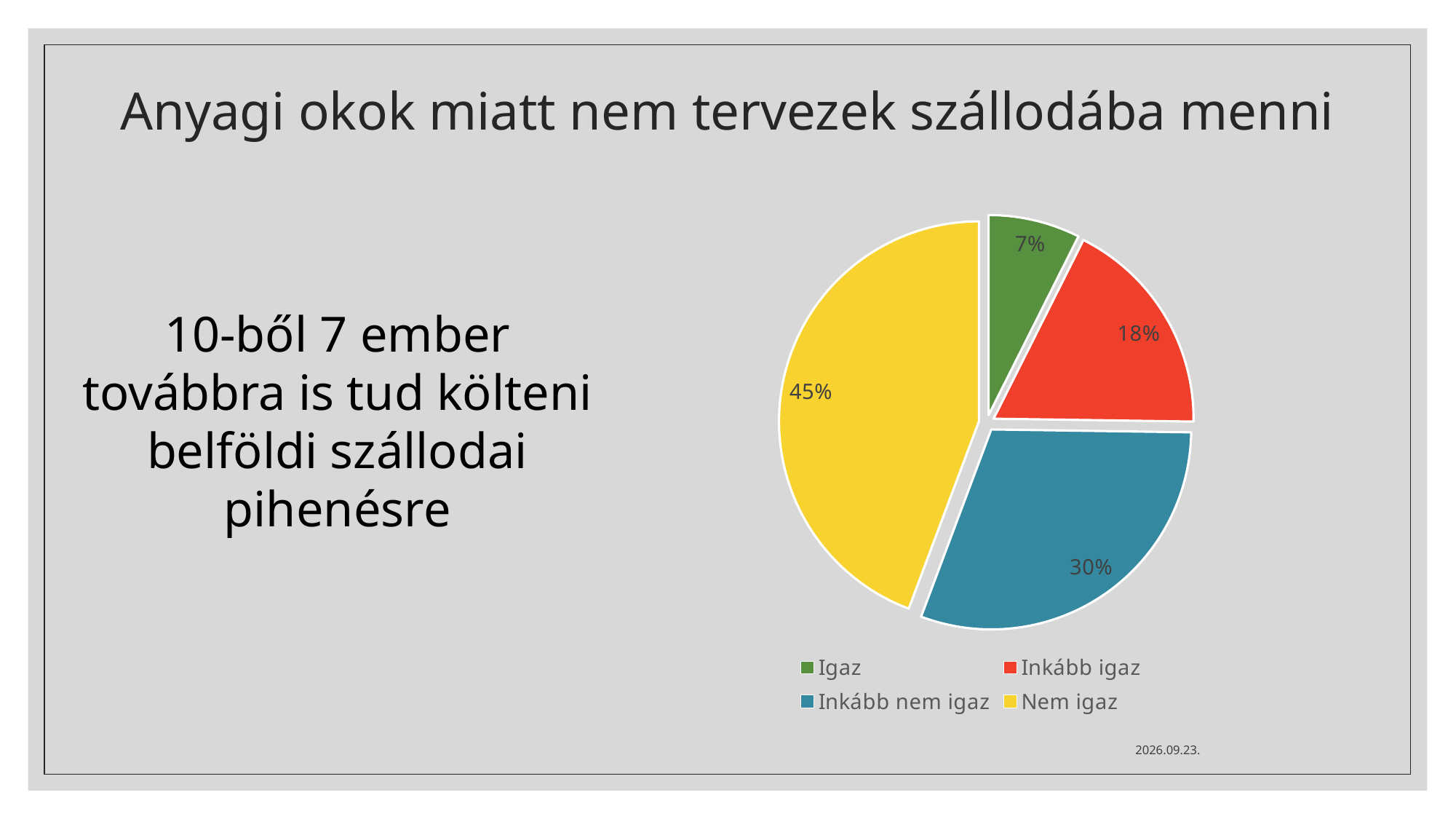
What is the difference in percentage points between "Nem igaz" and "Inkább nem igaz"? 15 Which category has the largest slice of the pie? Nem igaz What colour is the "Nem igaz" slice in the pie chart? Yellow What is the combined share of "Igaz" and "Inkább igaz"? 25% What kind of chart is shown on the slide? Pie chart What is the value shown for "Inkább nem igaz"? 30% Which is larger, the slice for "Inkább igaz" or the slice for "Inkább nem igaz"? Inkább nem igaz What share of the pie does the "Nem igaz" slice represent? 45% Which category has the smallest slice of the pie? Igaz What is the value shown for "Inkább igaz"? 18% What is the value shown for "Igaz"? 7% How many slices does the pie chart have? 4